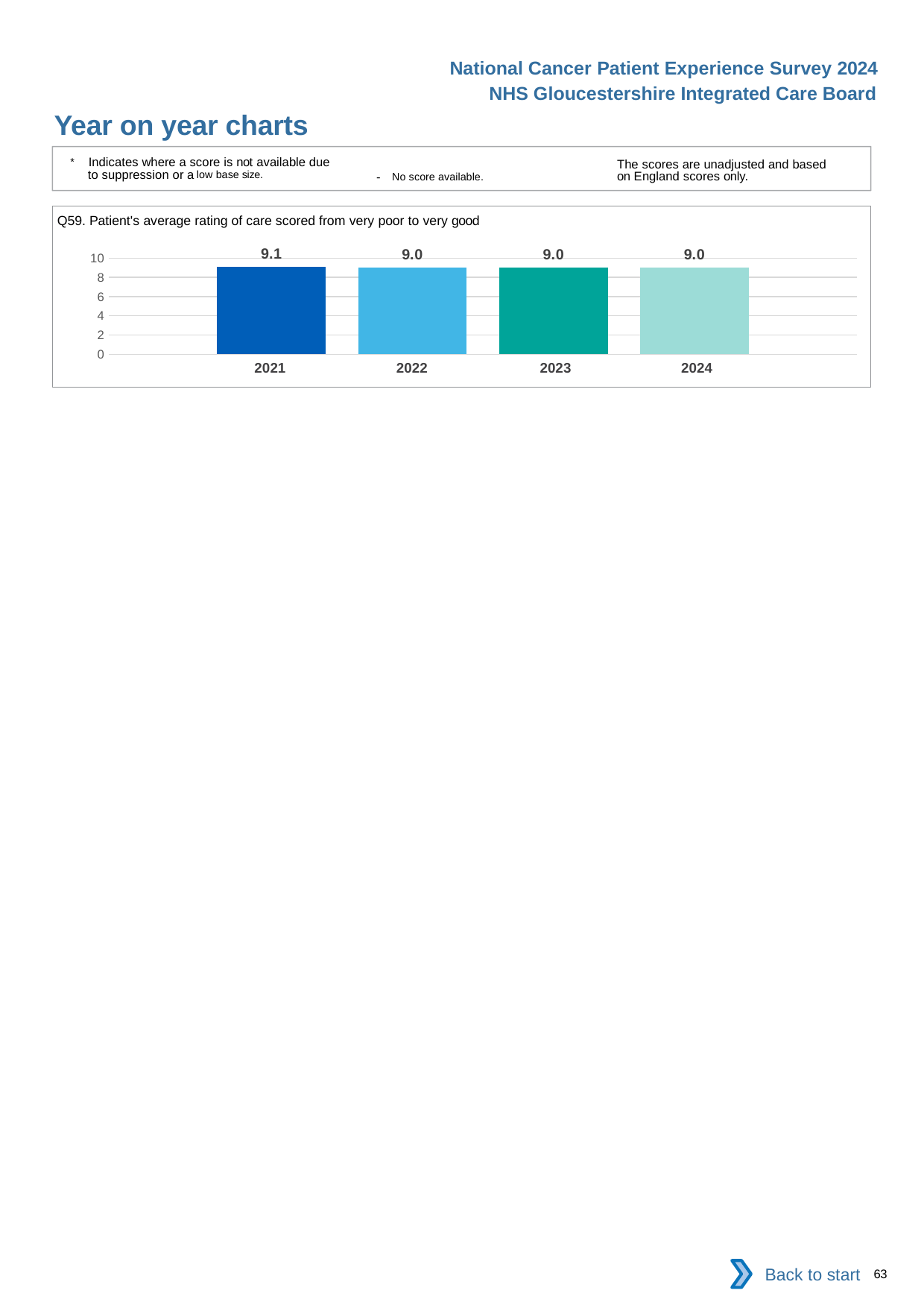
What is the value for 2024? 9.0 Which is larger, the value for 2021 or the value for 2022? 2021 Which year has the highest value? 2021 What is the value for 2021? 9.1 What kind of chart is shown? bar chart What is the title of the chart? Q59. Patient's average rating of care scored from very poor to very good What is the difference between the values for 2021 and 2023? 0.1 Is the value for 2023 greater or less than 8? greater What is the maximum value shown on the vertical axis? 10 What is the value for 2022? 9.0 How many years are shown on the chart? 4 Do the values rise or fall from 2021 to 2022? fall